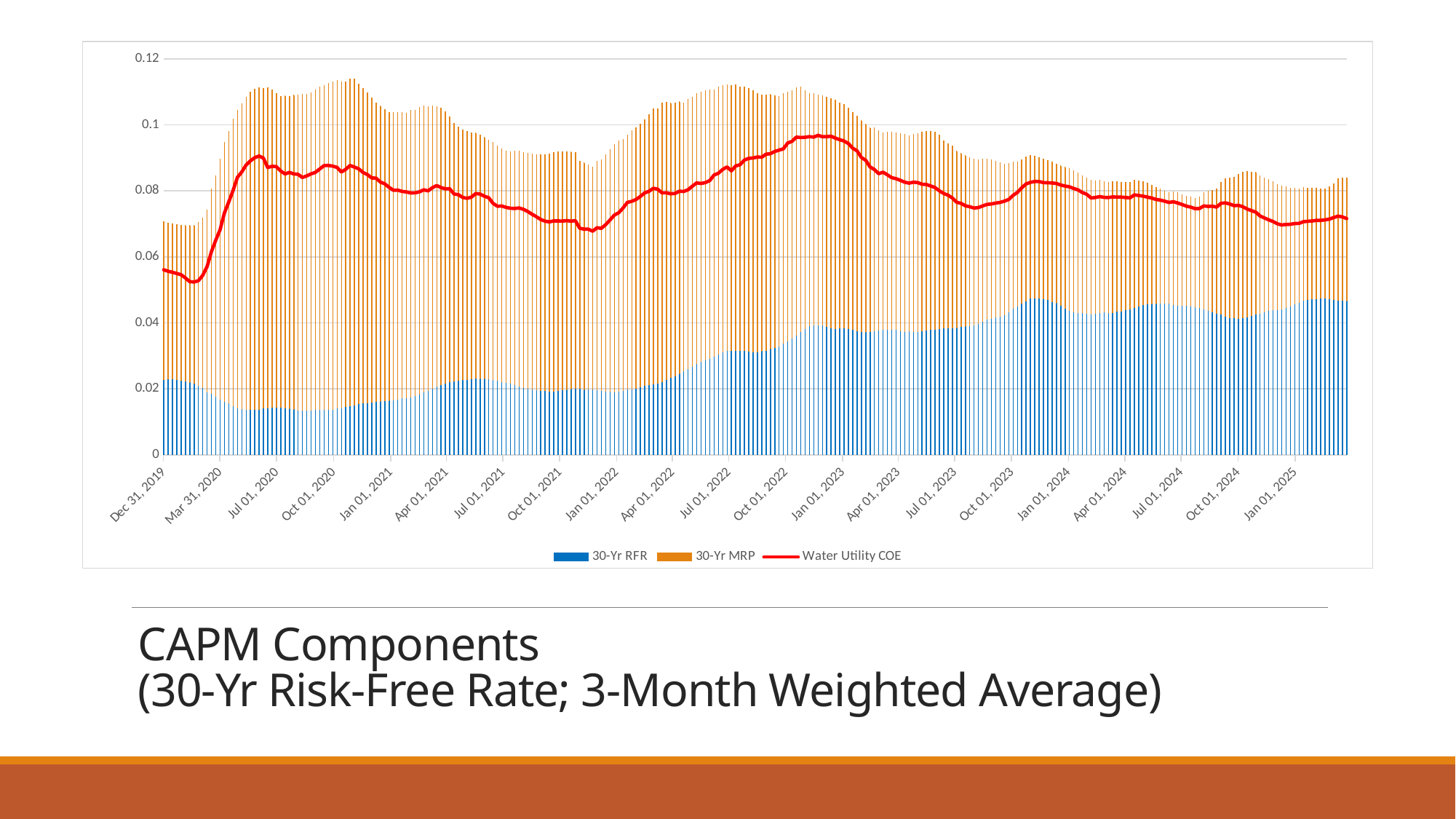
Does the Water Utility COE line rise or fall between Jan 01, 2023 and Jan 01, 2025? Fall How many series does the legend list? 3 Is the 30-Yr RFR value at Jul 01, 2020 greater or less than 0.02? less Is the Water Utility COE value at Jan 01, 2023 greater or less than 0.08? greater Does the 30-Yr RFR rise or fall between Jan 01, 2022 and Jan 01, 2024? Rise What colour are the 30-Yr MRP bars? Orange What kind of chart is this? Stacked bar chart with a line overlay Is the Water Utility COE value at Dec 31, 2019 greater or less than 0.06? less Which series is drawn as a red line? Water Utility COE Which is larger, the Water Utility COE at Jan 01, 2023 or at Jan 01, 2022? Jan 01, 2023